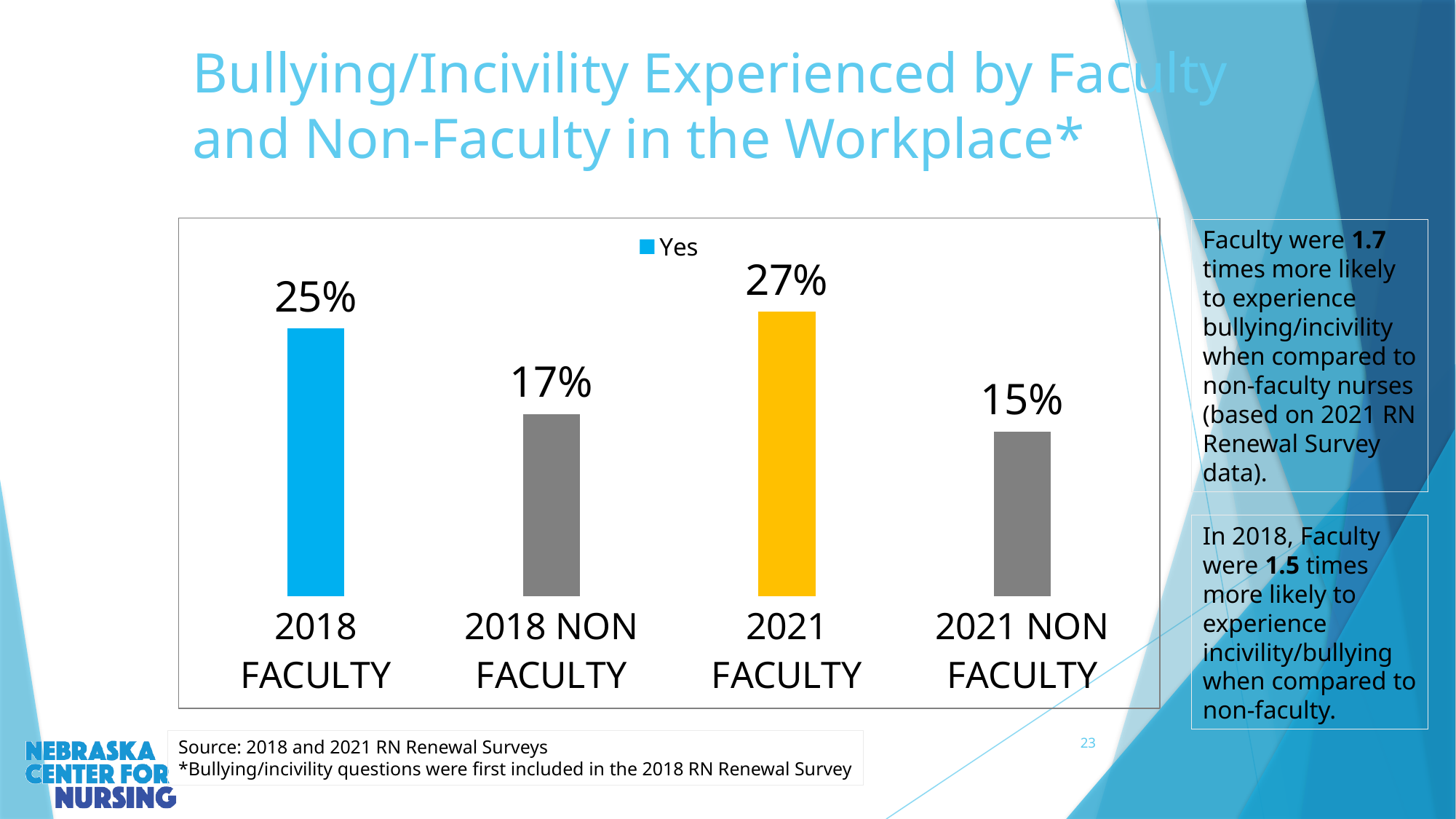
What is the value for 2018 FACULTY? 25% What is the value for 2021 FACULTY? 27% What is the difference between the values for 2018 FACULTY and 2018 NON FACULTY? 8% Which category has the highest value? 2021 FACULTY What is the difference between the values for 2021 FACULTY and 2021 NON FACULTY? 12% How many categories are shown in the chart? 4 What is the value for 2018 NON FACULTY? 17% Which category has the lowest value? 2021 NON FACULTY Which is larger, the value for 2018 NON FACULTY or 2021 NON FACULTY? 2018 NON FACULTY What series name does the legend show? Yes What is the value for 2021 NON FACULTY? 15% What kind of chart is shown on the slide? bar chart